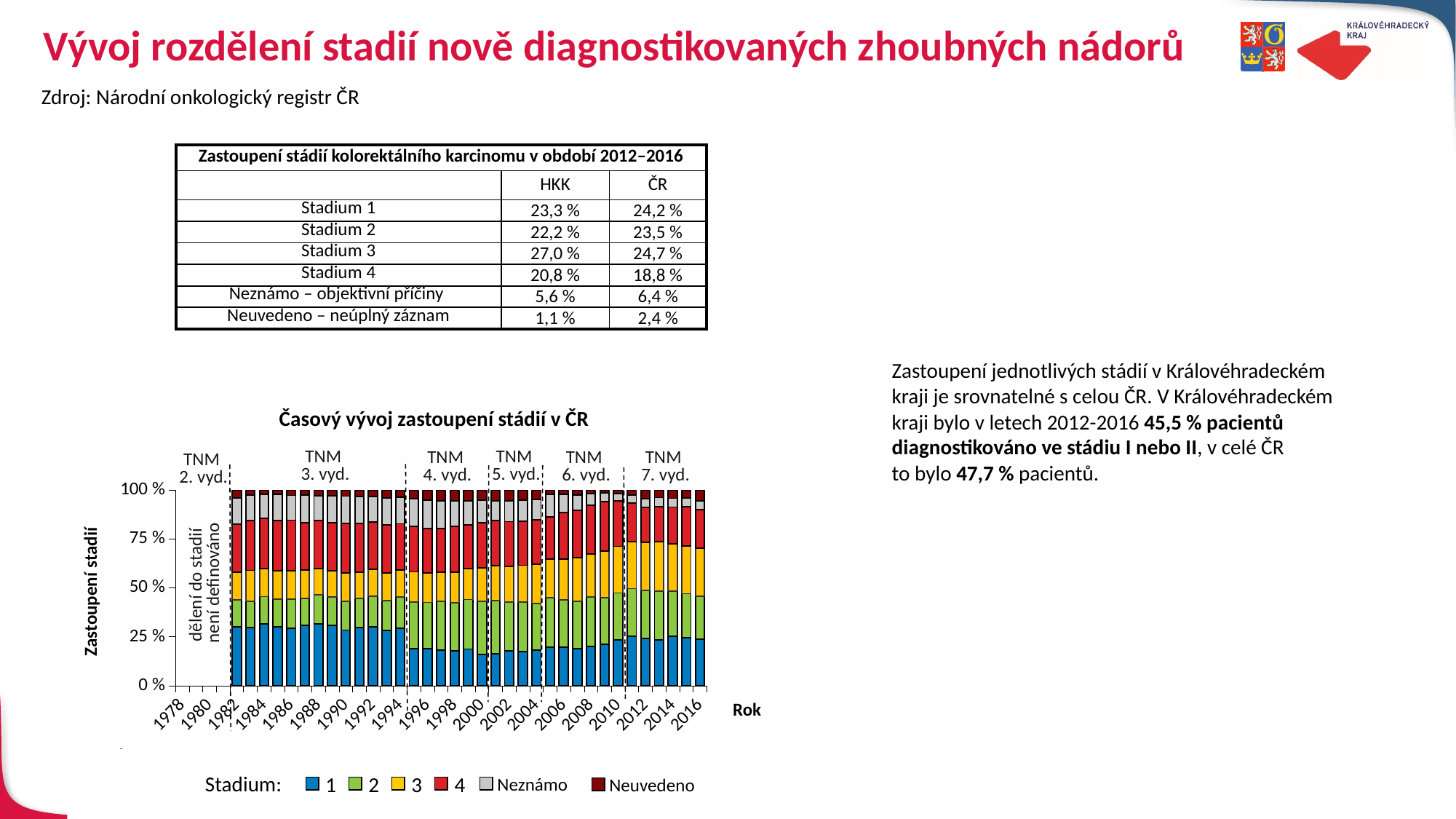
In the chart "Časový vývoj zastoupení stádií v ČR", does the share of Stadium 1 rise or fall between 1982 and 2000? fall In the chart "Časový vývoj zastoupení stádií v ČR", is the share of Stadium 1 in 2000 greater or less than 25 %? less In the chart "Časový vývoj zastoupení stádií v ČR", does the share of Neznámo rise or fall between 1982 and 2016? fall In the chart "Časový vývoj zastoupení stádií v ČR", is the share of Stadium 1 in 1982 greater or less than 25 %? greater What is the label of the x axis of the chart "Časový vývoj zastoupení stádií v ČR"? Rok In the chart "Časový vývoj zastoupení stádií v ČR", which year has the larger share of Stadium 1: 1982 or 2000? 1982 In the chart "Časový vývoj zastoupení stádií v ČR", what is the highest value shown on the y axis? 100 % What kind of chart is "Časový vývoj zastoupení stádií v ČR"? stacked bar chart In the chart "Časový vývoj zastoupení stádií v ČR", which colour represents Stadium 1 in the legend? blue In the chart "Časový vývoj zastoupení stádií v ČR", is the share of Stadium 1 in 1996 greater or less than 25 %? less How many series does the legend of the chart "Časový vývoj zastoupení stádií v ČR" list? 6